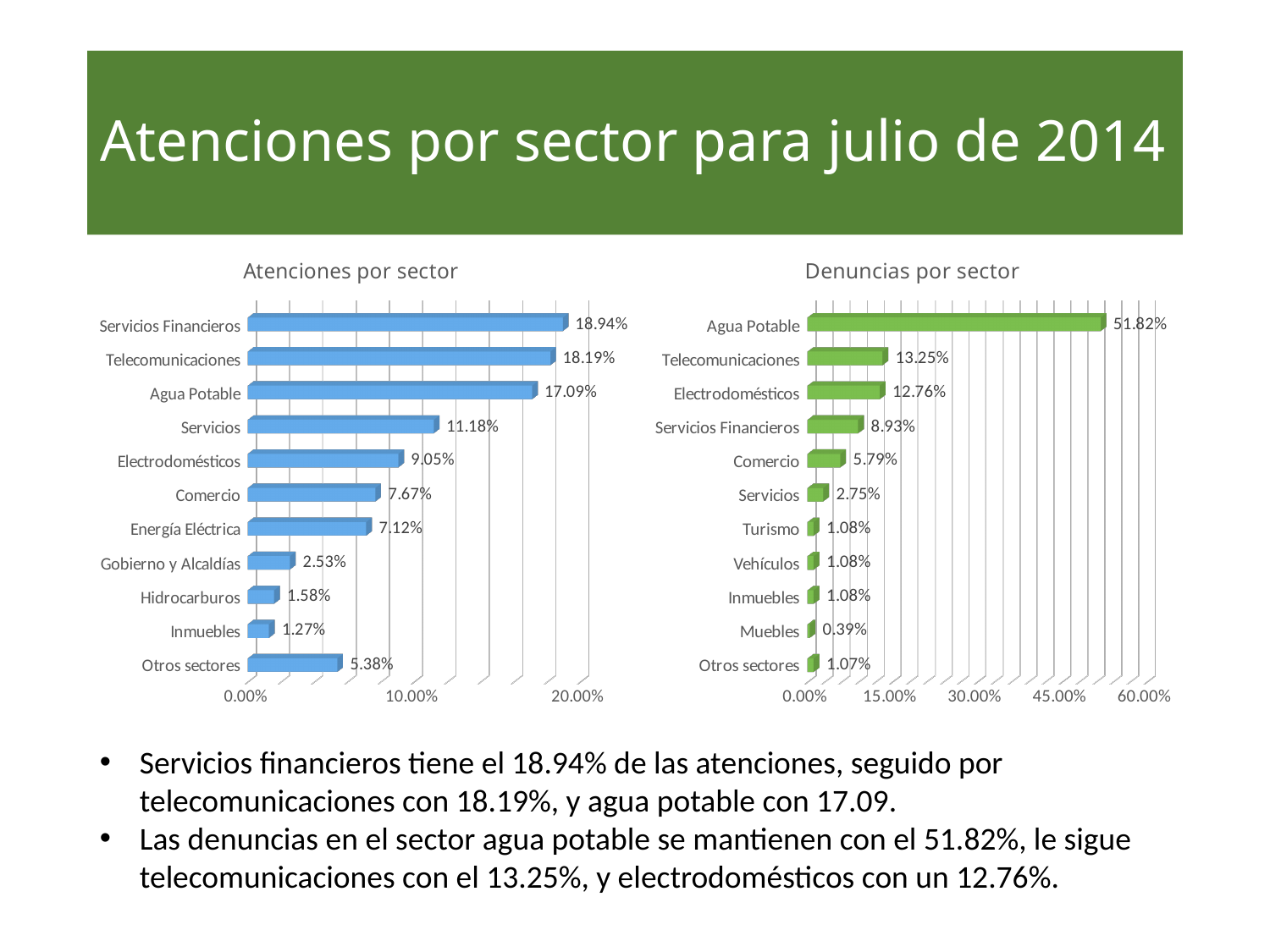
In the 'Atenciones por sector' chart, what is the value for Telecomunicaciones? 18.19% In the 'Denuncias por sector' chart, what is the difference between Agua Potable and Telecomunicaciones? 38.57% What kind of chart is the 'Denuncias por sector' chart? Bar chart In the 'Denuncias por sector' chart, what is the value for Electrodomésticos? 12.76% In the 'Atenciones por sector' chart, which is larger: Electrodomésticos or Energía Eléctrica? Electrodomésticos How many categories are shown in the 'Denuncias por sector' chart? 11 In the 'Atenciones por sector' chart, what is the difference between Agua Potable and Comercio? 9.42% In the 'Denuncias por sector' chart, which category has the lowest value? Muebles What colour are the bars in the 'Atenciones por sector' chart? Blue How many categories are shown in the 'Atenciones por sector' chart? 11 In the 'Atenciones por sector' chart, which category has the highest value? Servicios Financieros In the 'Denuncias por sector' chart, is the value for Agua Potable greater or less than 45.00%? greater